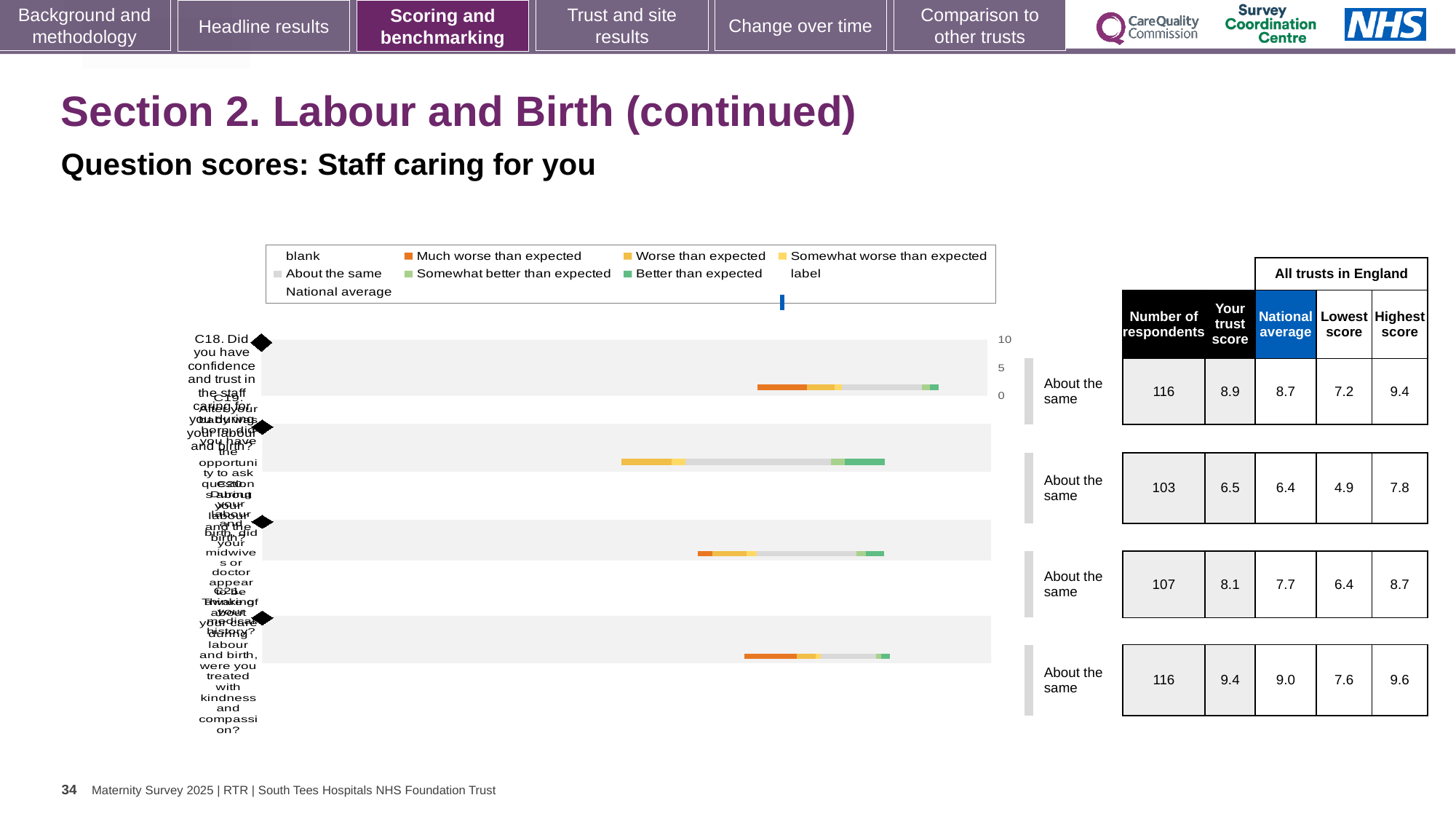
How many question rows (bars) are plotted in the chart? 4 In the table beside the chart, which row has the highest 'Your trust score'? the bottom row, C21 (9.4) In the table beside the chart, what is 'Your trust score' for the bottom row, C21? 9.4 In the table beside the chart, what is the number of respondents for the first (top) row, C18? 116 In the chart legend, which colour represents 'Much worse than expected'? orange What benchmark category is shown next to each bar in the chart? About the same In the table beside the chart, what is the 'Highest score' for the second row? 7.8 In the table beside the chart, for the top row (C18), which is larger: 'Your trust score' or the 'National average'? Your trust score In the table beside the chart, which row has the lowest 'Your trust score'? the second row (6.5) In the table beside the chart, what is the difference between 'Your trust score' and the 'National average' for the bottom row? 0.4 What kind of chart is shown on the slide? bar chart